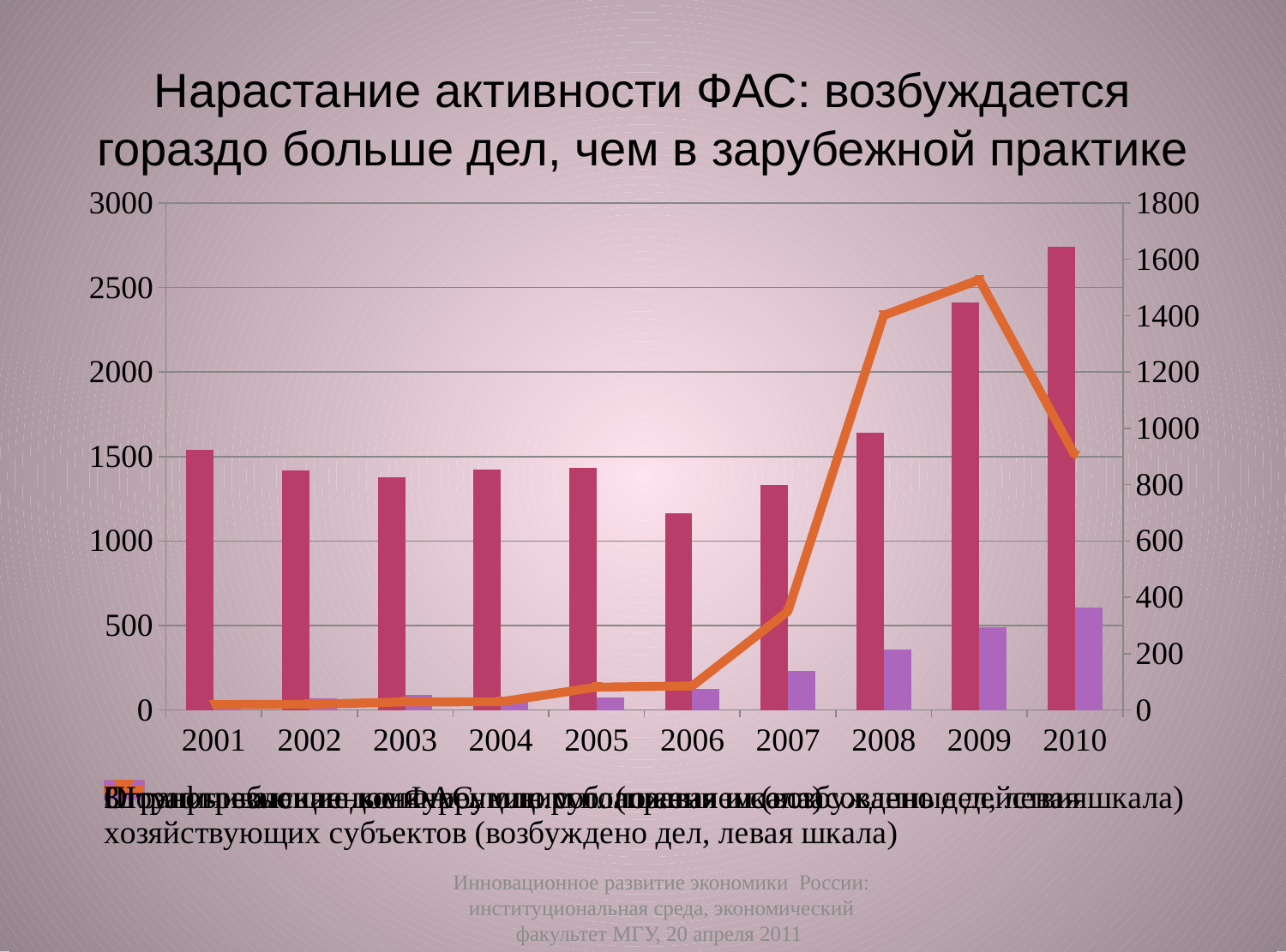
Does the orange line rise or fall from 2007 to 2009? rise Which year has the shortest dark pink bar? 2006 Is the dark pink bar for 2010 greater or less than 2500 on the left scale? greater Is the dark pink bar for 2006 greater or less than 1500 on the left scale? less Which year has the tallest dark pink bar? 2010 Which is larger, the dark pink bar for 2001 or the dark pink bar for 2006? 2001 Is the orange line value for 2008 greater or less than 1200 on the right scale? greater How many years are shown on the x axis of the chart? 10 In which year does the orange line reach its highest point? 2009 What kind of chart is shown on the slide? A bar chart combined with a line Which year has the tallest purple bar? 2010